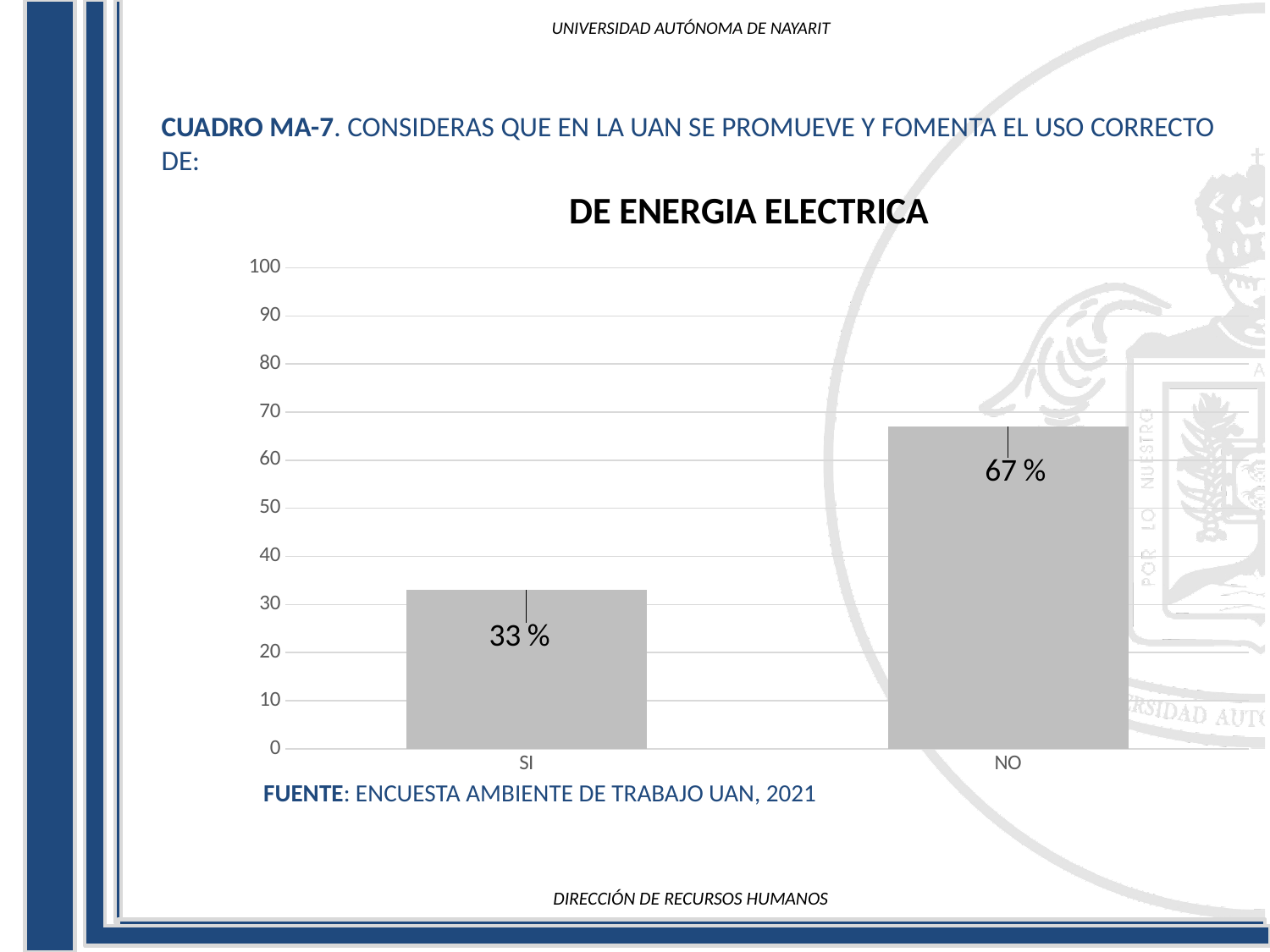
Is the value for NO greater or less than 60? greater What is the value for NO? 67 % Which category has the lowest value? SI How many categories are shown on the x axis? 2 Which is larger, the value for SI or the value for NO? NO Is the value for SI greater or less than 40? less What is the value for SI? 33 % What is the title of the chart? DE ENERGIA ELECTRICA What is the highest value shown on the y axis? 100 What is the difference between the values for NO and SI? 34 % What kind of chart is shown on the slide? bar chart Which category has the highest value? NO